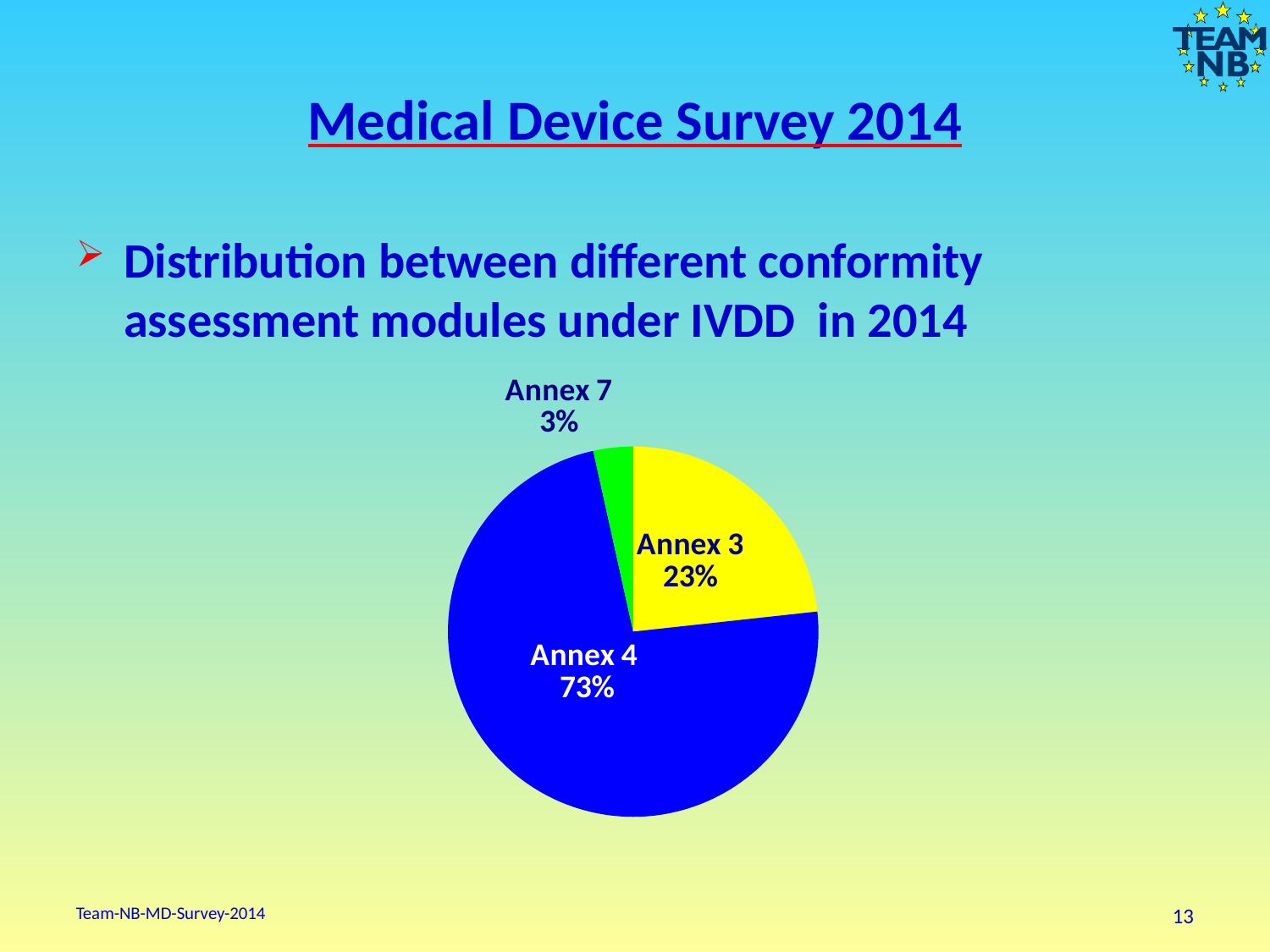
What is the difference in percentage points between Annex 4 and Annex 3? 50 Which annex has the largest share of the pie? Annex 4 What colour is the Annex 4 slice? blue What colour is the Annex 3 slice? yellow How many slices does the pie chart have? 3 What is the difference in percentage points between Annex 3 and Annex 7? 20 What share of the pie does Annex 7 represent? 3% Which annex has the smallest share of the pie? Annex 7 What kind of chart is shown on the slide? pie chart Which is larger, the share for Annex 3 or the share for Annex 7? Annex 3 What share of the pie does Annex 4 represent? 73% What share of the pie does Annex 3 represent? 23%